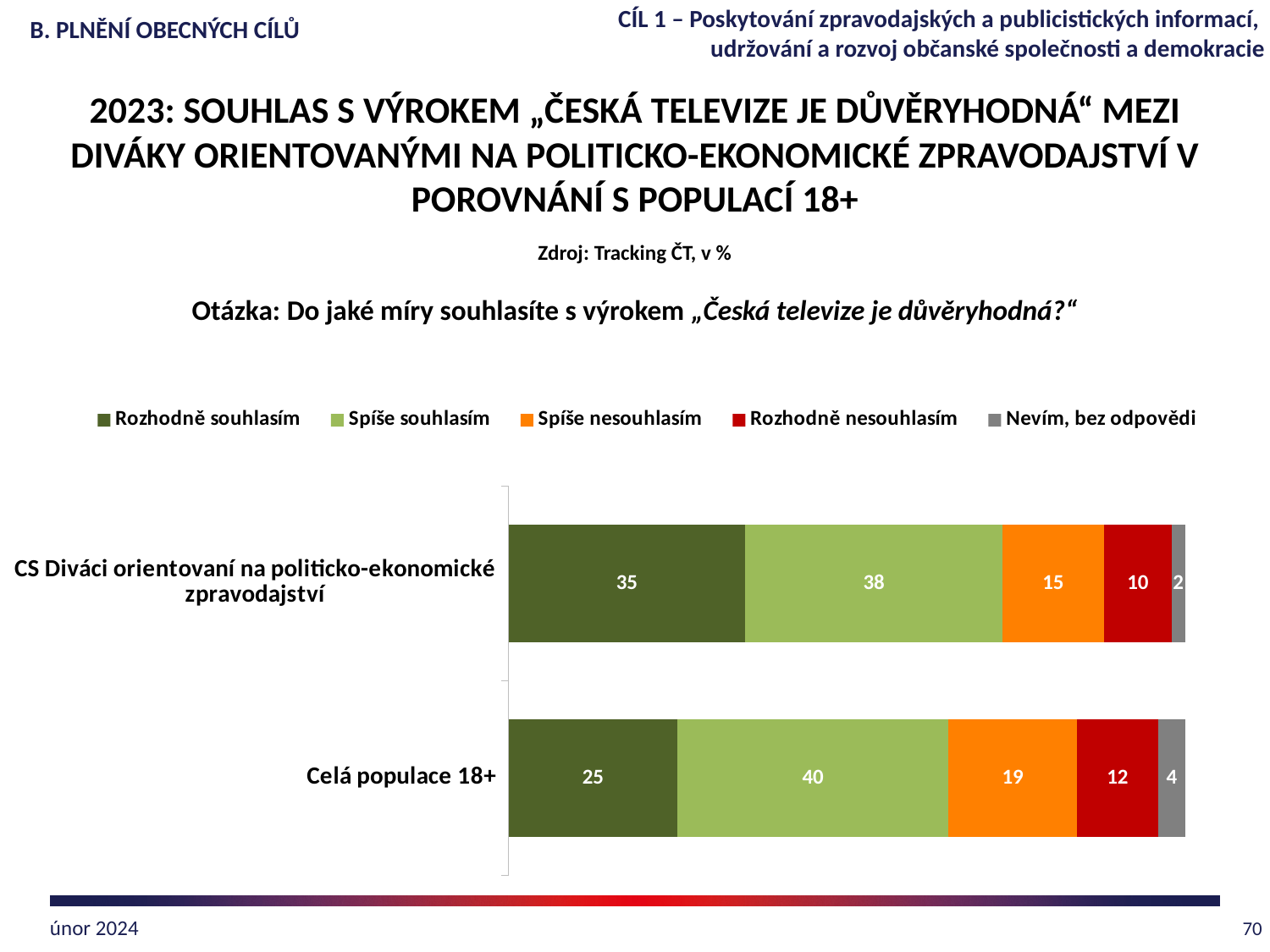
What is the value for "Nevím, bez odpovědi" in the "Celá populace 18+" bar? 4 Which segment is the smallest in the "CS Diváci orientovaní na politicko-ekonomické zpravodajství" bar? Nevím, bez odpovědi What is the difference between the "Rozhodně souhlasím" values of the two categories? 10 Which segment is the largest in the "Celá populace 18+" bar? Spíše souhlasím How many series does the legend list? 5 What is the difference between the "Spíše nesouhlasím" values of "Celá populace 18+" and "CS Diváci orientovaní na politicko-ekonomické zpravodajství"? 4 What is the value for "Rozhodně nesouhlasím" in the "CS Diváci orientovaní na politicko-ekonomické zpravodajství" bar? 10 What is the value for "Rozhodně souhlasím" in the "CS Diváci orientovaní na politicko-ekonomické zpravodajství" bar? 35 How many categories (bars) are shown in the chart? 2 Which category has the higher value for "Rozhodně souhlasím"? CS Diváci orientovaní na politicko-ekonomické zpravodajství What kind of chart is shown on the slide? Stacked bar chart What is the value for "Spíše souhlasím" in the "Celá populace 18+" bar? 40